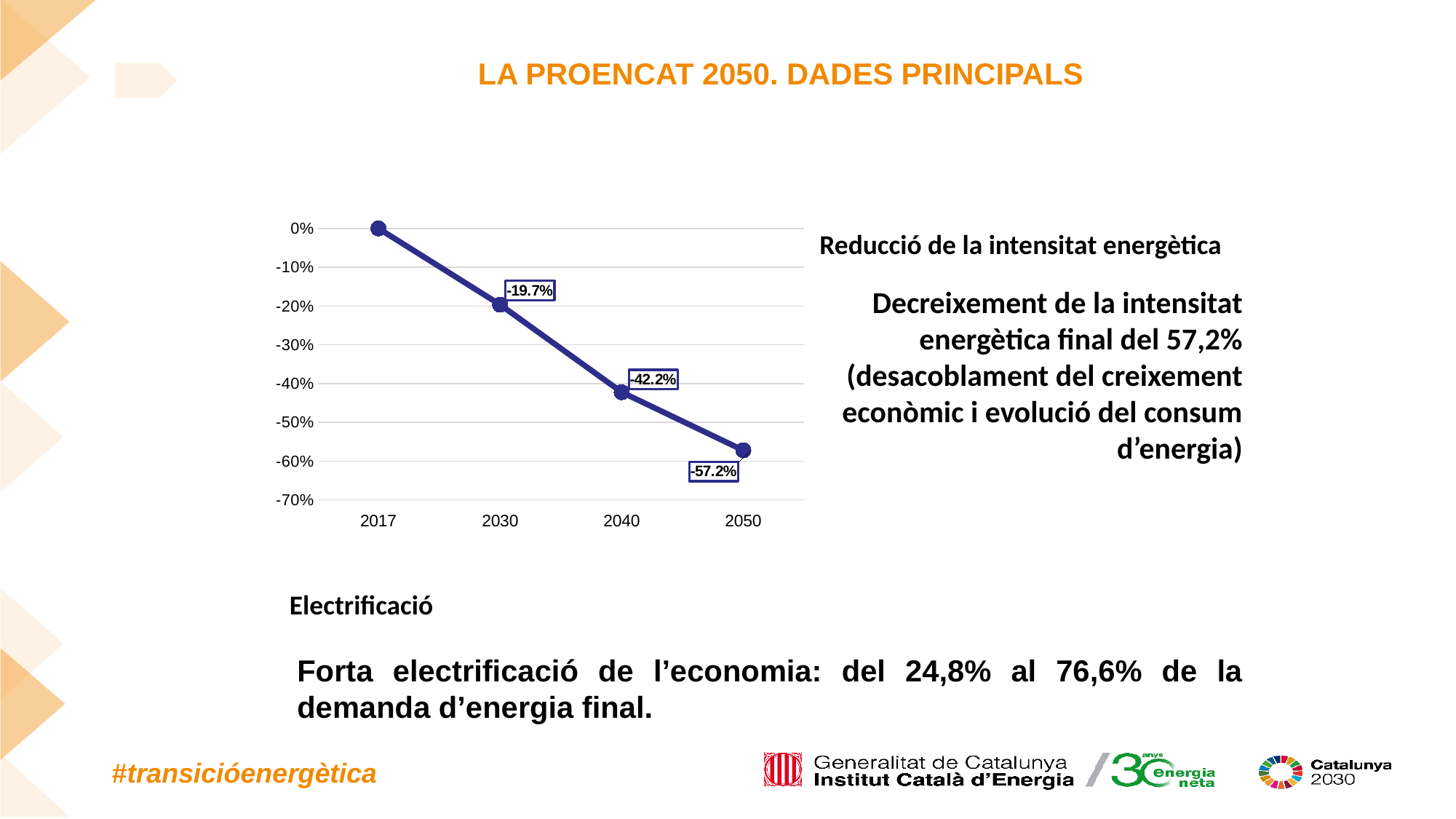
What kind of chart is shown on the slide? Line chart What is the value shown for 2040? -42.2% What is the difference between the values for 2030 and 2040? 22.5 percentage points Do the values rise or fall from 2017 to 2050? Fall How many data points are plotted on the chart? 4 Which year has the lowest value on the chart? 2050 What is the value shown for 2030? -19.7% What is the difference between the values for 2040 and 2050? 15.0 percentage points What is the value shown for 2050? -57.2% Which is larger, the value for 2030 or the value for 2040? 2030 Which year has the highest value on the chart? 2017 What is the value shown for 2017? 0%